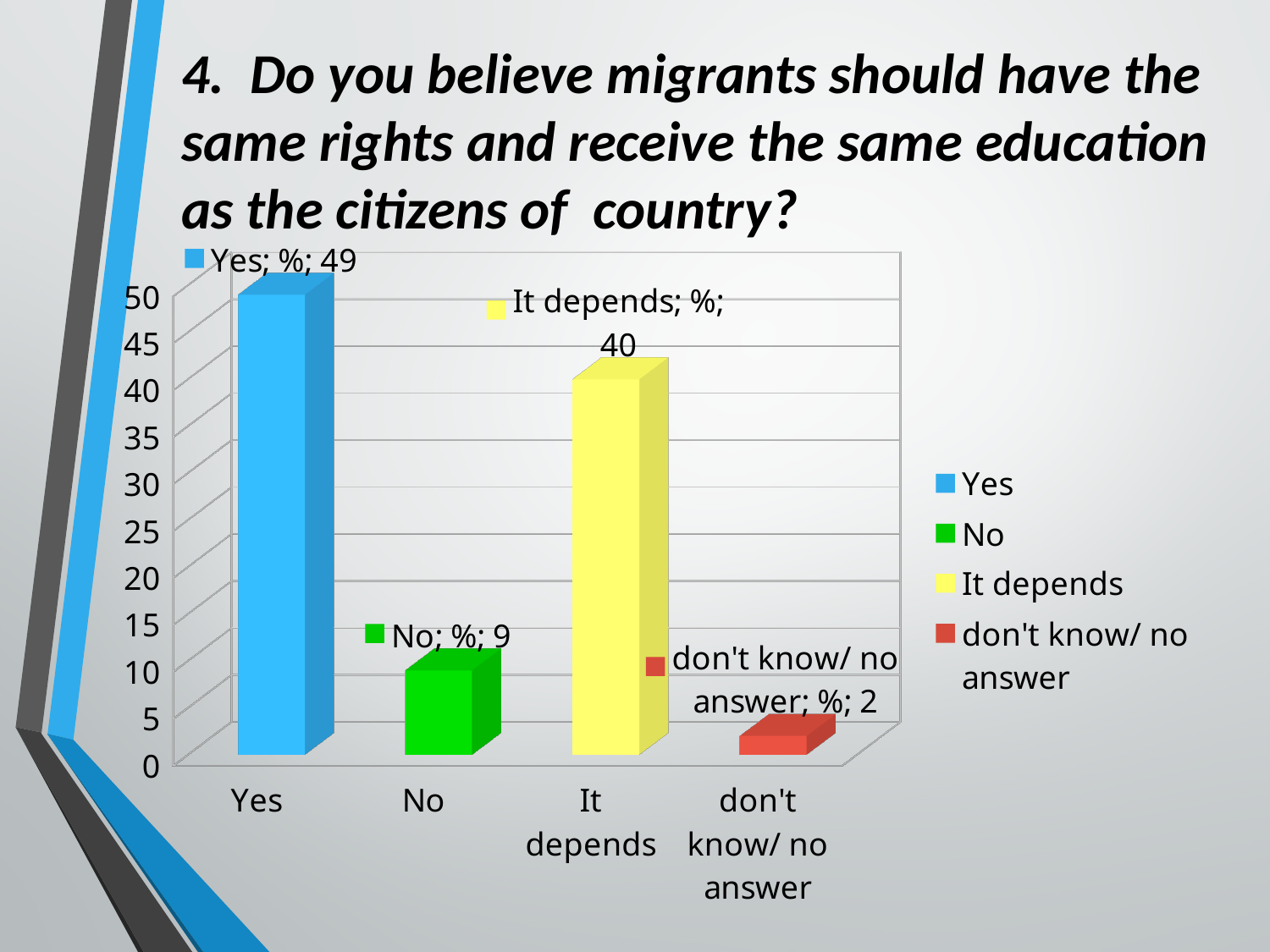
What is the value for Yes? 49 How many entries does the legend list? 4 What kind of chart is shown on the slide? bar chart Which category has the highest value? Yes What is the value for It depends? 40 What is the value for don't know/ no answer? 2 What is the value for No? 9 How many categories are shown on the x axis? 4 Which category has the lowest value? don't know/ no answer Which is larger, the value for No or the value for It depends? It depends What is the difference between the values for Yes and It depends? 9 What is the difference between the values for No and don't know/ no answer? 7